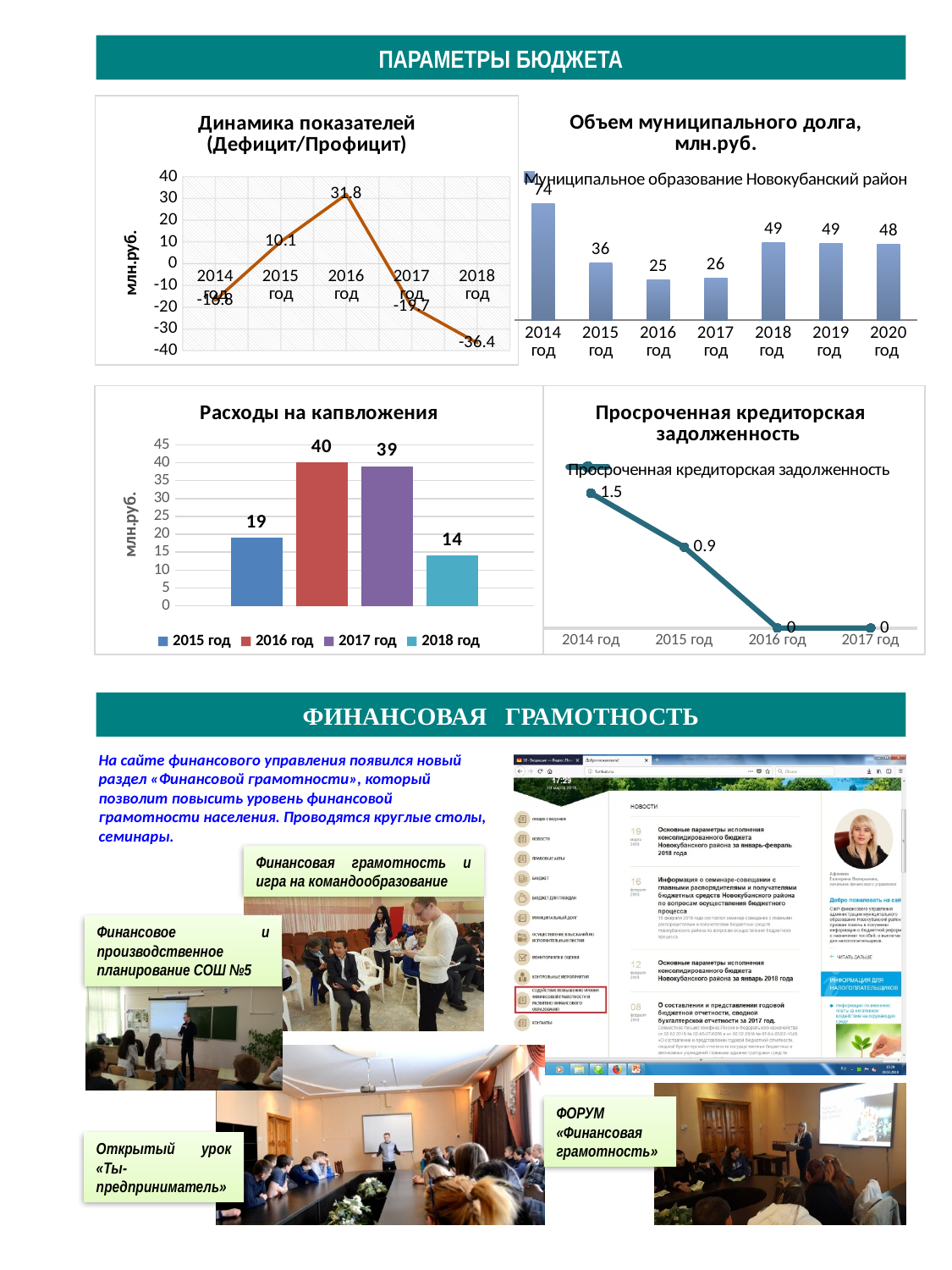
In the chart 'Расходы на капвложения', what is the value for 2017 год? 39 In the chart 'Динамика показателей (Дефицит/Профицит)', what is the value for 2016 год? 31.8 In the chart 'Просроченная кредиторская задолженность', do the values rise or fall from 2014 год to 2016 год? fall In the chart 'Расходы на капвложения', which year has the highest value? 2016 год In the chart 'Объем муниципального долга, млн.руб.', what is the difference between the values for 2014 год and 2015 год? 38 In the chart 'Объем муниципального долга, млн.руб.', what is the value for 2014 год? 74 In the chart 'Расходы на капвложения', how many series does the legend list? 4 In the chart 'Динамика показателей (Дефицит/Профицит)', what is the difference between the values for 2016 год and 2015 год? 21.7 In the chart 'Динамика показателей (Дефицит/Профицит)', which year has the lowest value? 2018 год In the chart 'Объем муниципального долга, млн.руб.', which year has the lowest value? 2016 год In the chart 'Просроченная кредиторская задолженность', what is the value for 2015 год? 0.9 In the chart 'Объем муниципального долга, млн.руб.', how many years are shown? 7